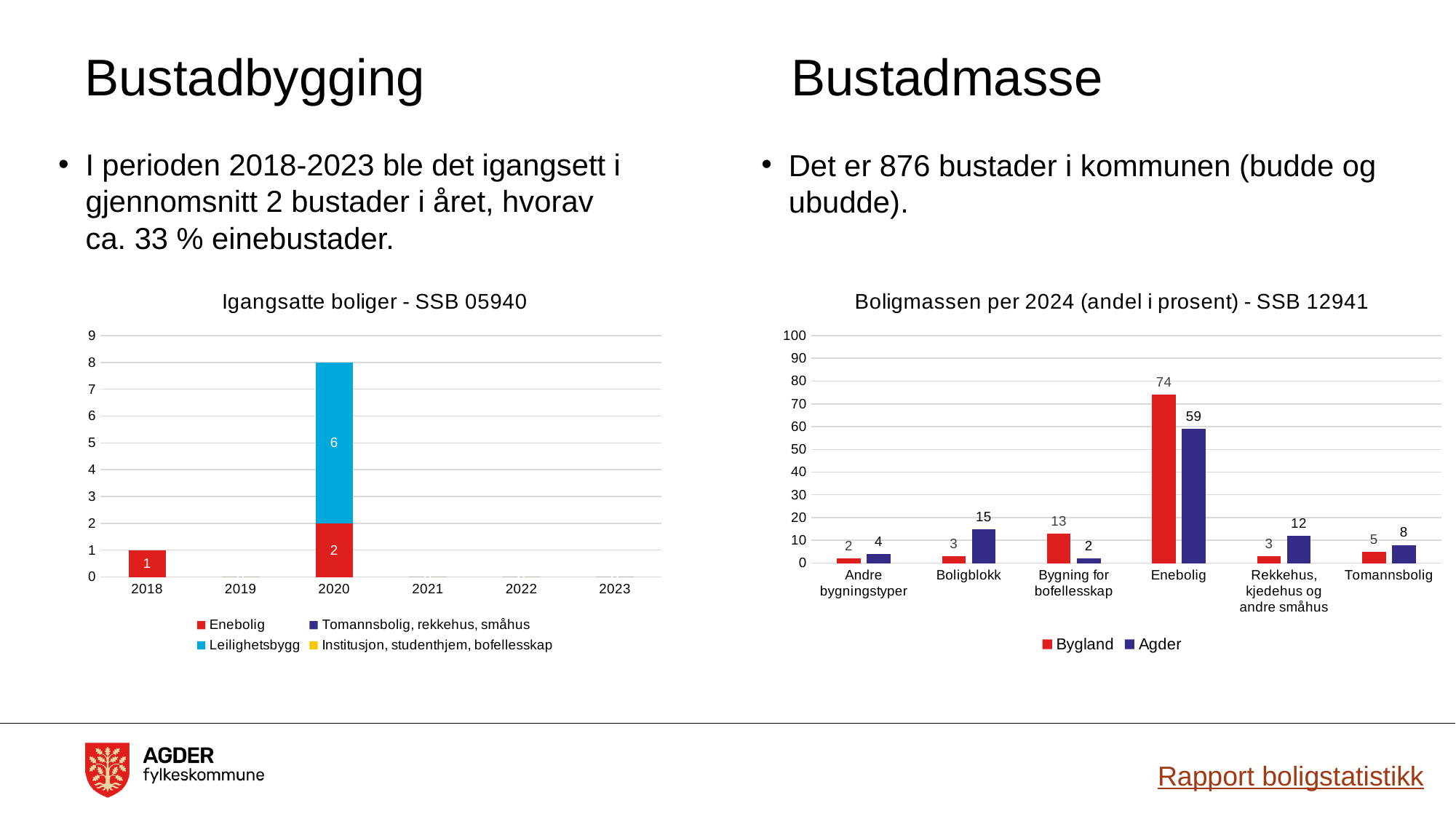
In the 'Boligmassen per 2024 (andel i prosent) - SSB 12941' chart, what is the Agder value for Boligblokk? 15 In the 'Igangsatte boliger - SSB 05940' chart, how many years are shown on the x axis? 6 In the 'Igangsatte boliger - SSB 05940' chart, how many series does the legend list? 4 In the 'Igangsatte boliger - SSB 05940' chart, what is the total height of the stacked bar for 2020? 8 In the 'Igangsatte boliger - SSB 05940' chart, what is the Leilighetsbygg value for 2020? 6 In the 'Boligmassen per 2024 (andel i prosent) - SSB 12941' chart, which is larger for Bygning for bofellesskap, Bygland or Agder? Bygland In the 'Boligmassen per 2024 (andel i prosent) - SSB 12941' chart, which category has the lowest Bygland value? Andre bygningstyper In the 'Igangsatte boliger - SSB 05940' chart, what is the Enebolig value for 2020? 2 What kind of chart is 'Boligmassen per 2024 (andel i prosent) - SSB 12941'? Bar chart In the 'Igangsatte boliger - SSB 05940' chart, which year has the highest total? 2020 In the 'Boligmassen per 2024 (andel i prosent) - SSB 12941' chart, what is the Bygland value for Enebolig? 74 In the 'Boligmassen per 2024 (andel i prosent) - SSB 12941' chart, what is the difference between the Bygland and Agder values for Enebolig? 15